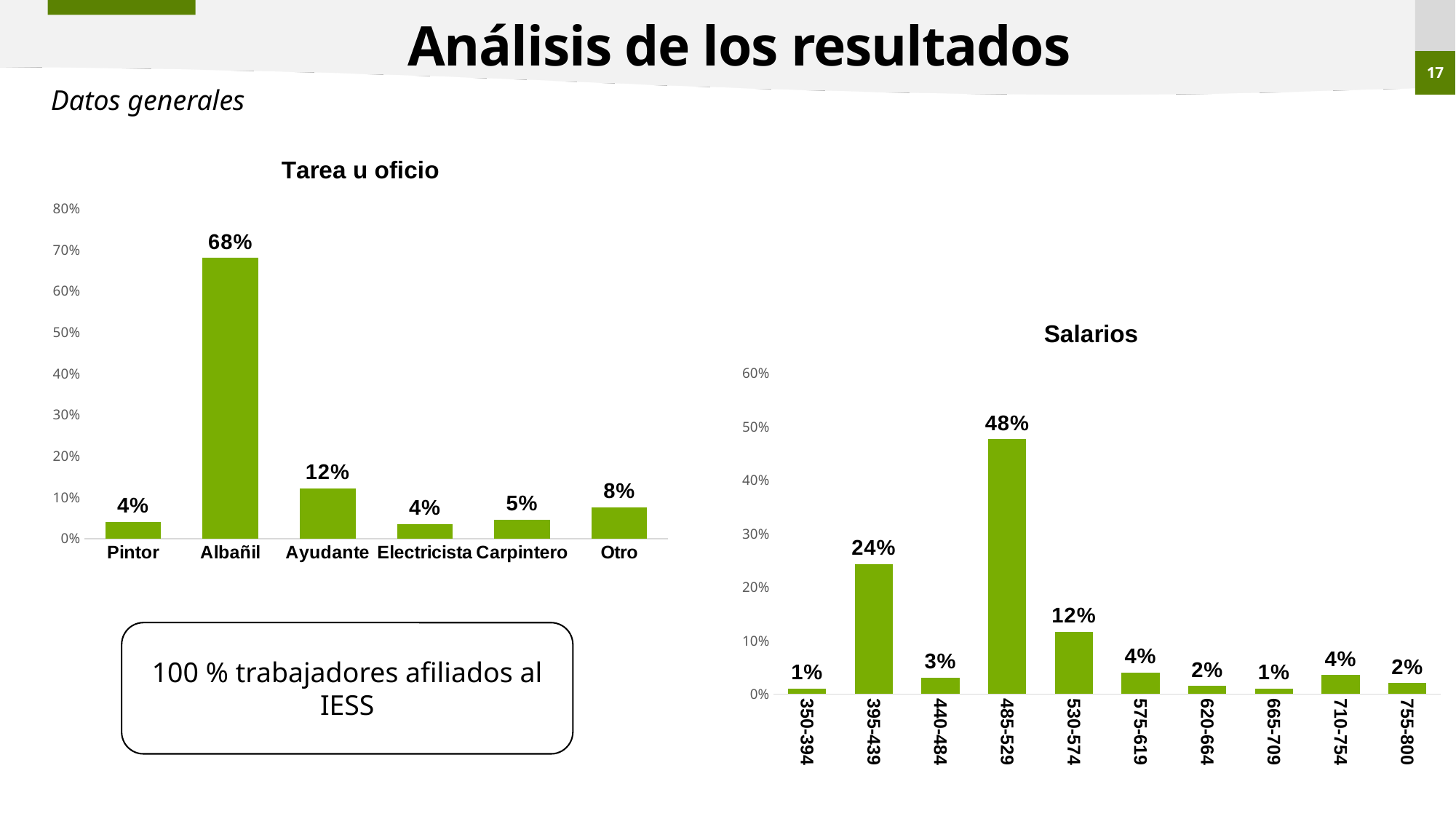
In the 'Tarea u oficio' chart, what is the difference between Ayudante and Otro? 4% What is the title of the chart on the left side of the slide? Tarea u oficio In the 'Tarea u oficio' chart, how many categories are shown? 6 In the 'Salarios' chart, how many salary ranges are shown? 10 What kind of chart is the 'Salarios' chart? Bar chart In the 'Salarios' chart, what is the difference between 485-529 and 395-439? 24% In the 'Salarios' chart, what is the value for 395-439? 24% In the 'Tarea u oficio' chart, which is larger, Carpintero or Otro? Otro In the 'Salarios' chart, which salary range has the highest value? 485-529 In the 'Tarea u oficio' chart, which category has the highest value? Albañil In the 'Salarios' chart, what is the value for 530-574? 12% In the 'Tarea u oficio' chart, what is the value for Albañil? 68%